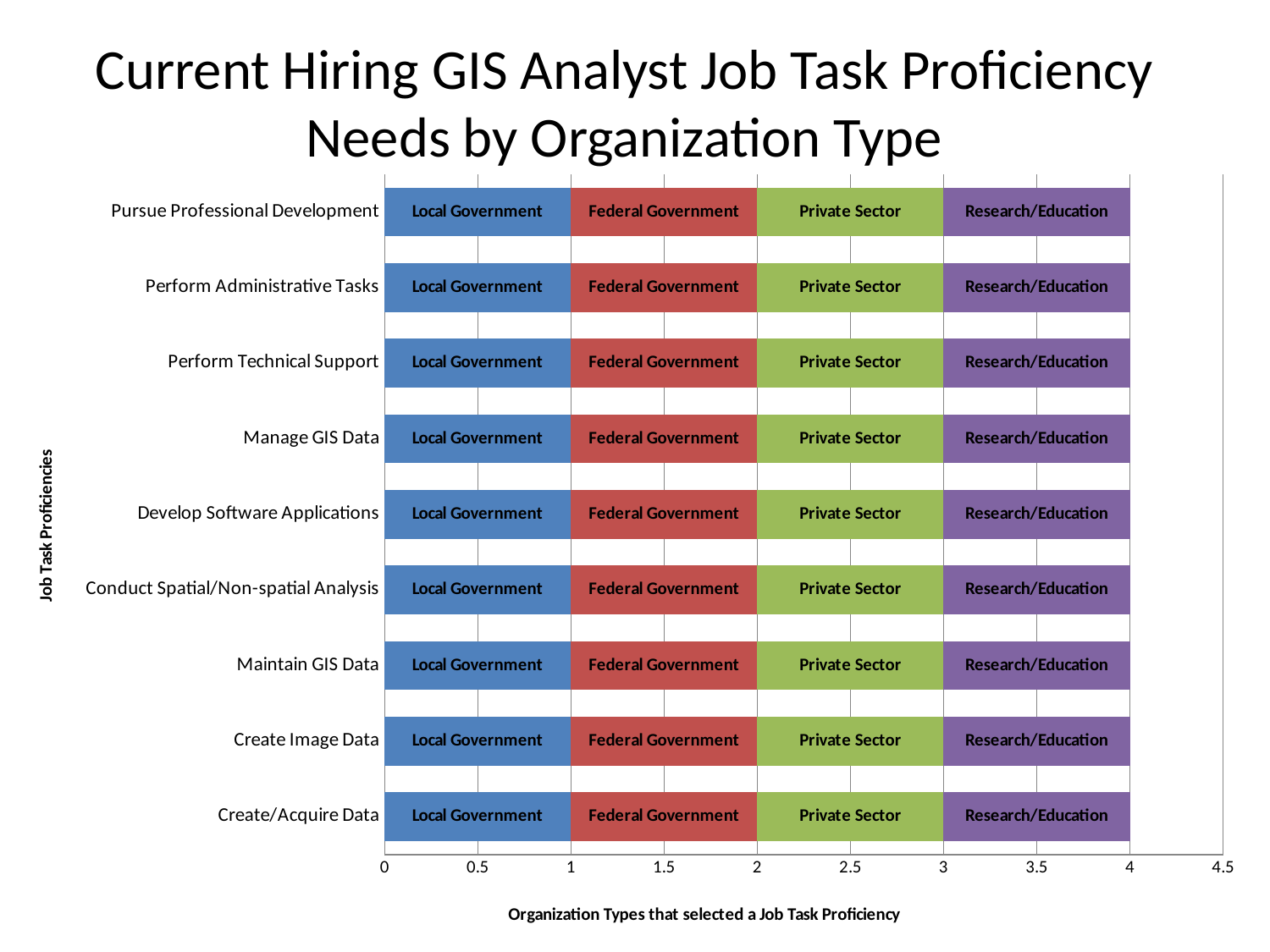
How many organization types are shown as segments in each bar? 4 At what axis value does the Private Sector segment end for Maintain GIS Data? 3 Is the total for Create Image Data greater or less than 4.5? less What colour are the Private Sector segments? Green What is the total length of the stacked bar for Pursue Professional Development? 4 Is the total for Develop Software Applications greater or less than 3.5? greater What value does the Local Government segment reach for Manage GIS Data? 1 How many job task proficiencies are listed on the vertical axis? 9 What kind of chart is shown on the slide? Stacked bar chart What is the title of the chart? Current Hiring GIS Analyst Job Task Proficiency Needs by Organization Type What is the total length of the stacked bar for Create/Acquire Data? 4 At what axis value does the Federal Government segment end for Perform Technical Support? 2